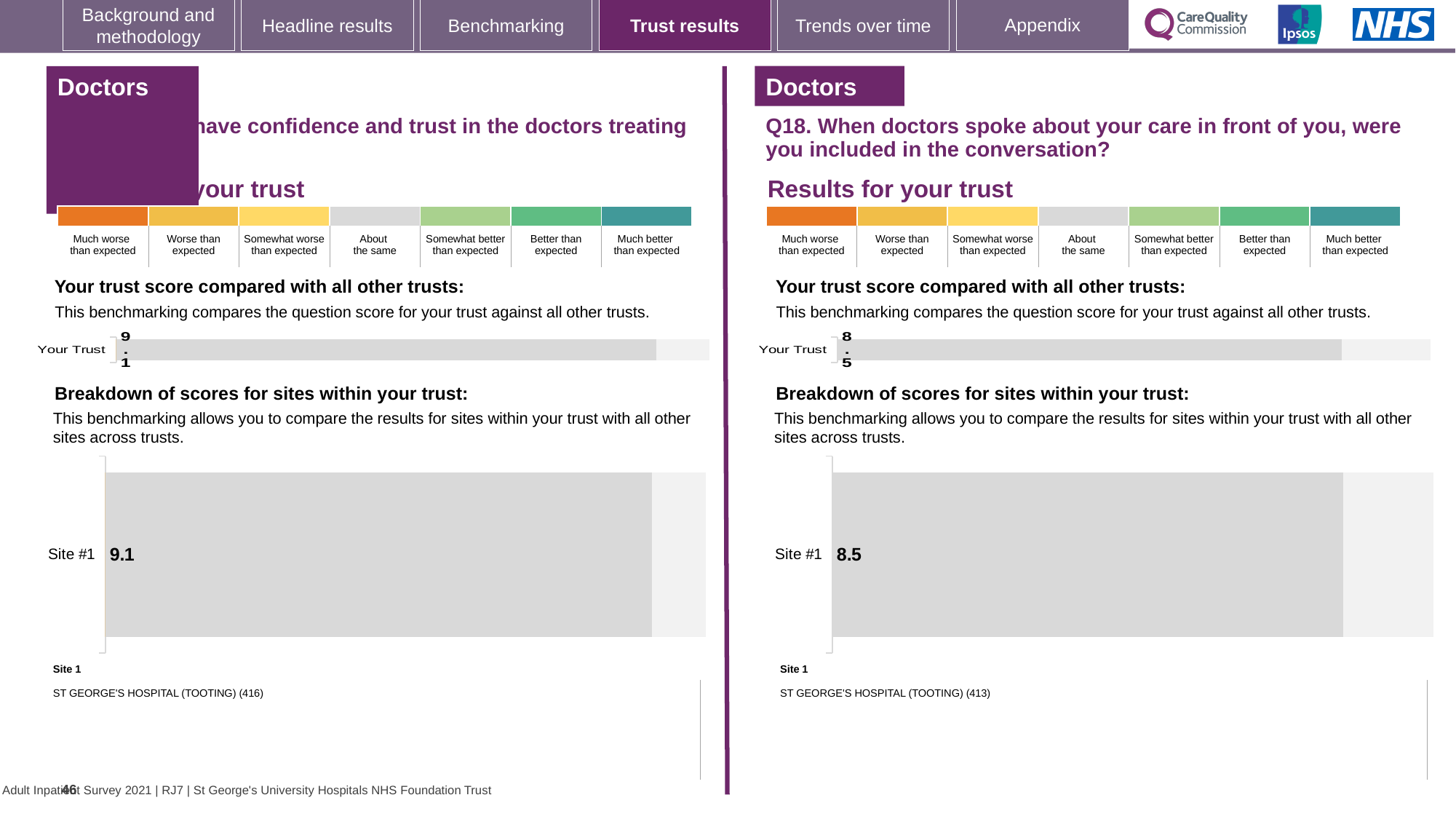
On the right half of the slide (Q18), what is the score shown for Your Trust in the 'Your trust score compared with all other trusts' chart? 8.5 Is the Your Trust score on the right half of the slide (Q18) greater or less than the Your Trust score on the left half? less How many sites are shown in the right (Q18) 'Breakdown of scores for sites within your trust' chart? 1 Which is larger: the Site #1 score in the left breakdown chart or the Site #1 score in the right (Q18) breakdown chart? The left chart (9.1) On the left half of the slide, what is the score shown for Your Trust in the 'Your trust score compared with all other trusts' chart? 9.1 In the right 'Breakdown of scores for sites within your trust' chart (Q18), what is the value for Site #1? 8.5 How many sites are shown in the left 'Breakdown of scores for sites within your trust' chart? 1 What type of chart is used to show the Site #1 score in the breakdown charts? Bar chart Which site is listed as Site 1 under the right (Q18) breakdown chart? ST GEORGE'S HOSPITAL (TOOTING) (413) Which site is listed as Site 1 under the left breakdown chart? ST GEORGE'S HOSPITAL (TOOTING) (416) In the left 'Breakdown of scores for sites within your trust' chart, what is the value for Site #1? 9.1 What is the difference between the Your Trust score on the left half of the slide and the Your Trust score on the right half (Q18)? 0.6